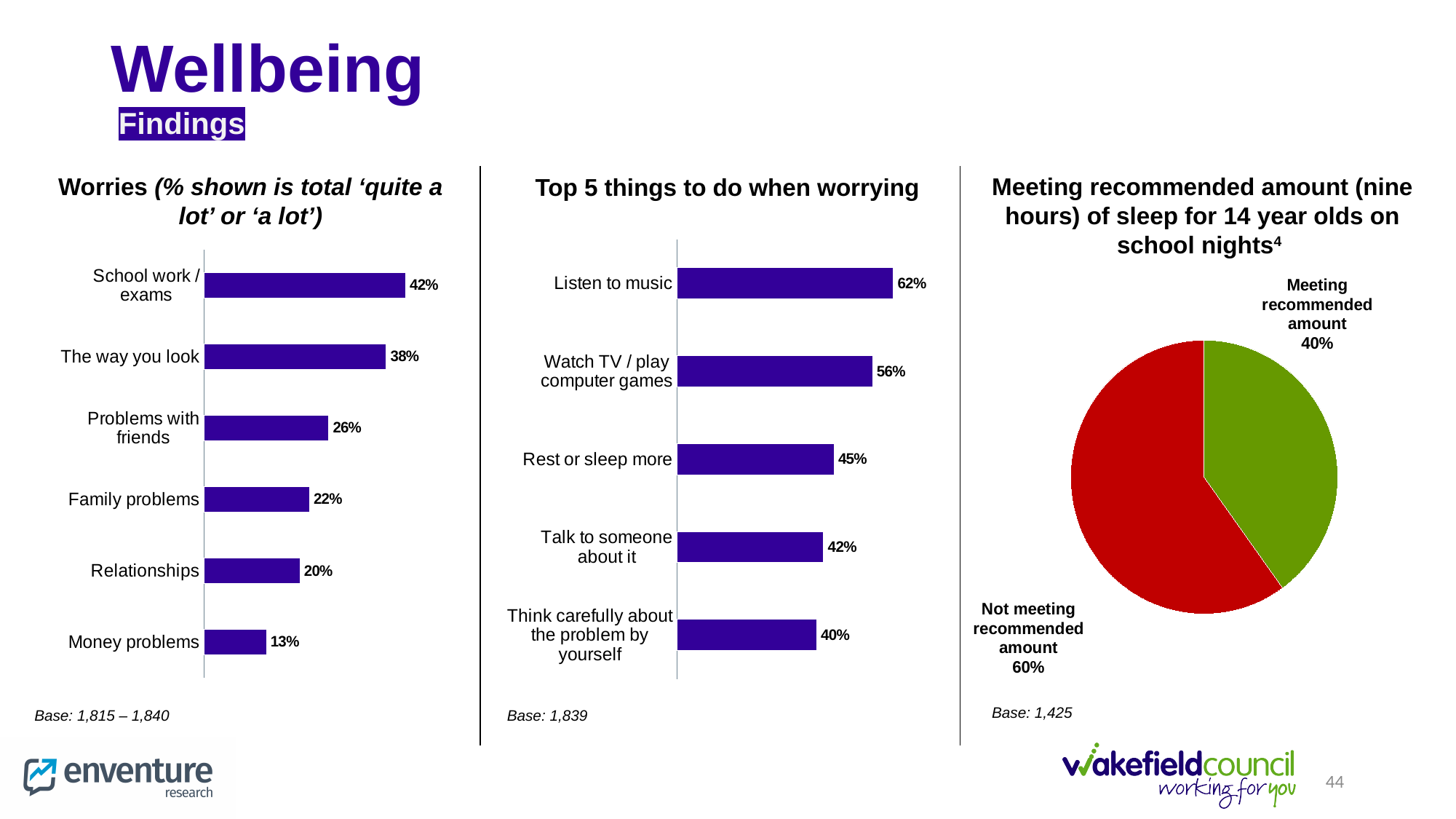
In the 'Worries' chart, how many categories are shown? 6 In the 'Worries' chart, what percentage is shown for 'School work / exams'? 42% What kind of chart is the 'Top 5 things to do when worrying' chart? Bar chart In the 'Meeting recommended amount (nine hours) of sleep' chart, what share is 'Not meeting recommended amount'? 60% In the 'Top 5 things to do when worrying' chart, what percentage is shown for 'Rest or sleep more'? 45% In the 'Worries' chart, which category has the lowest value? Money problems What kind of chart is the 'Meeting recommended amount (nine hours) of sleep' chart? Pie chart In the 'Top 5 things to do when worrying' chart, which category has the highest value? Listen to music In the 'Worries' chart, what is the difference between 'The way you look' and 'Family problems'? 16% In the 'Top 5 things to do when worrying' chart, which is larger: 'Watch TV / play computer games' or 'Talk to someone about it'? Watch TV / play computer games In the 'Top 5 things to do when worrying' chart, what is the difference between 'Listen to music' and 'Think carefully about the problem by yourself'? 22% In the 'Meeting recommended amount (nine hours) of sleep' chart, what colour is the 'Meeting recommended amount' slice? Green